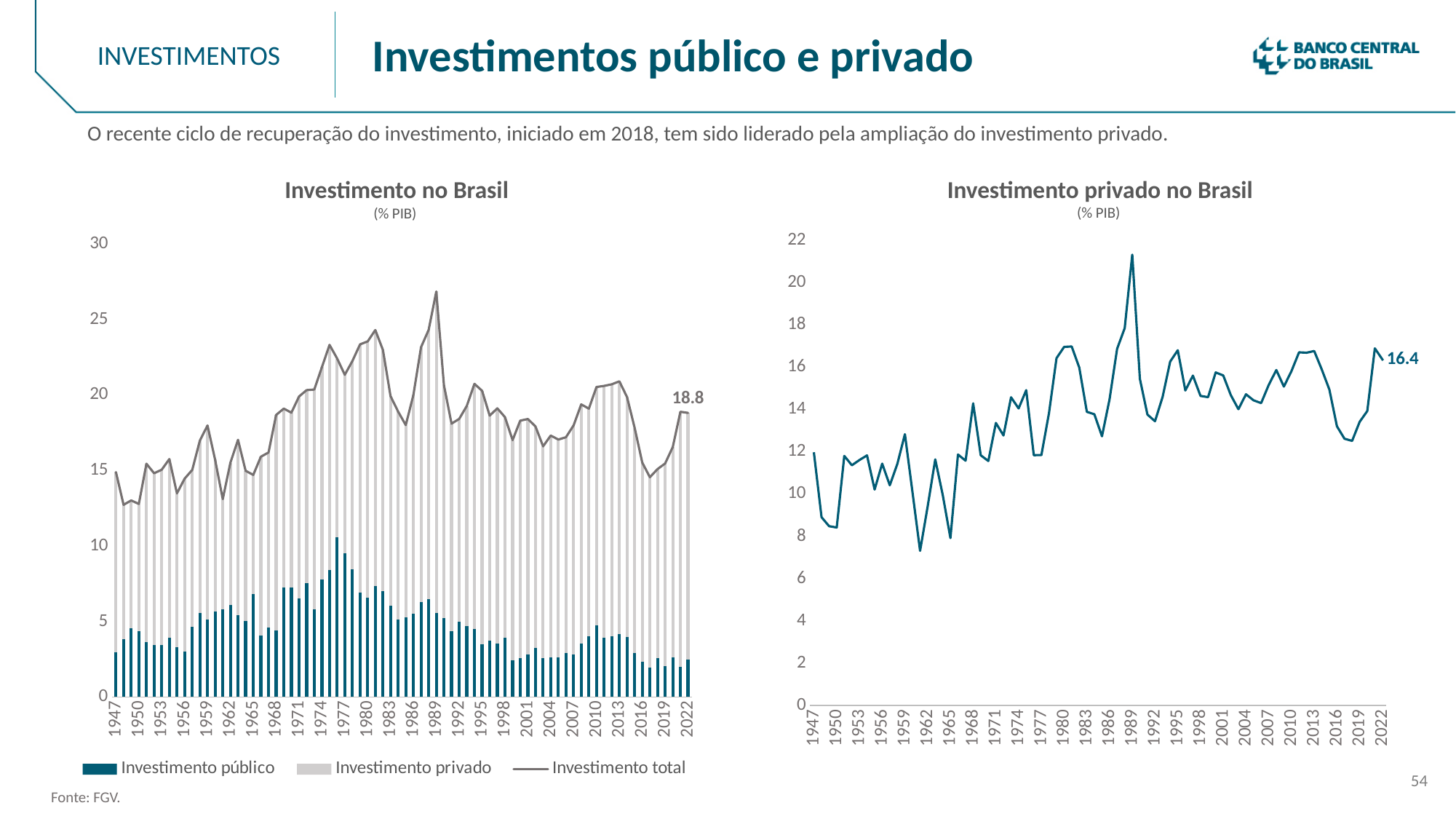
In the right chart 'Investimento privado no Brasil', is the value for 1989 greater or less than 20? greater What kind of chart is the right chart 'Investimento privado no Brasil'? Line chart In the left chart 'Investimento no Brasil', is the Investimento total value for 1989 greater or less than 25? greater In the right chart 'Investimento privado no Brasil', is the value for 1947 greater or less than 10? greater In the left chart 'Investimento no Brasil', what is the value of Investimento total in 2022? 18.8 In the right chart 'Investimento privado no Brasil', which year has the highest value? 1989 In the left chart 'Investimento no Brasil', which series is drawn as a line rather than bars? Investimento total In the right chart 'Investimento privado no Brasil', which is larger, the value for 2016 or the value for 2022? 2022 In the right chart 'Investimento privado no Brasil', do the values rise or fall from 2019 to 2022? rise How many series does the legend of the left chart 'Investimento no Brasil' list? 3 In the right chart 'Investimento privado no Brasil', what is the value in 2022? 16.4 What kind of chart is the left chart 'Investimento no Brasil'? Stacked bar chart with a line